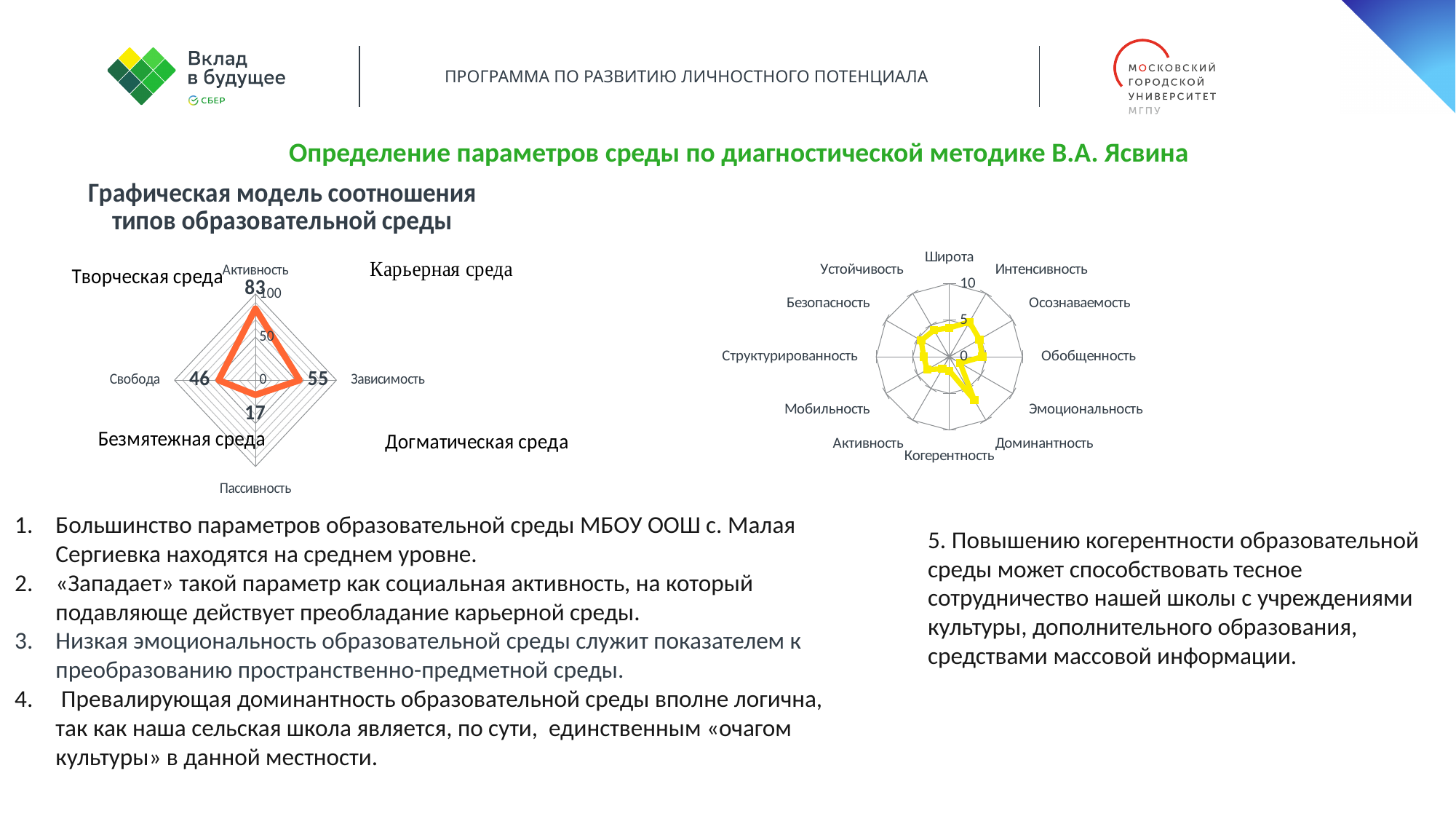
On the left chart, what is the value for Пассивность? 17 On the left chart, which axis has the lowest value? Пассивность On the left chart, what is the value for Свобода? 46 On the left chart, what is the difference between the values for Активность and Пассивность? 66 On the left chart (Графическая модель соотношения типов образовательной среды), what is the value for Активность? 83 On the right chart, how many parameters (axes) are plotted? 12 What kind of chart is the left chart? Radar chart On the left chart, which axis has the highest value? Активность On the left chart, which is larger: the value for Зависимость or the value for Свобода? Зависимость On the right chart, is the value for Доминантность greater or less than 5? greater On the left chart, how many axes (categories) are plotted? 4 On the left chart, what is the value for Зависимость? 55